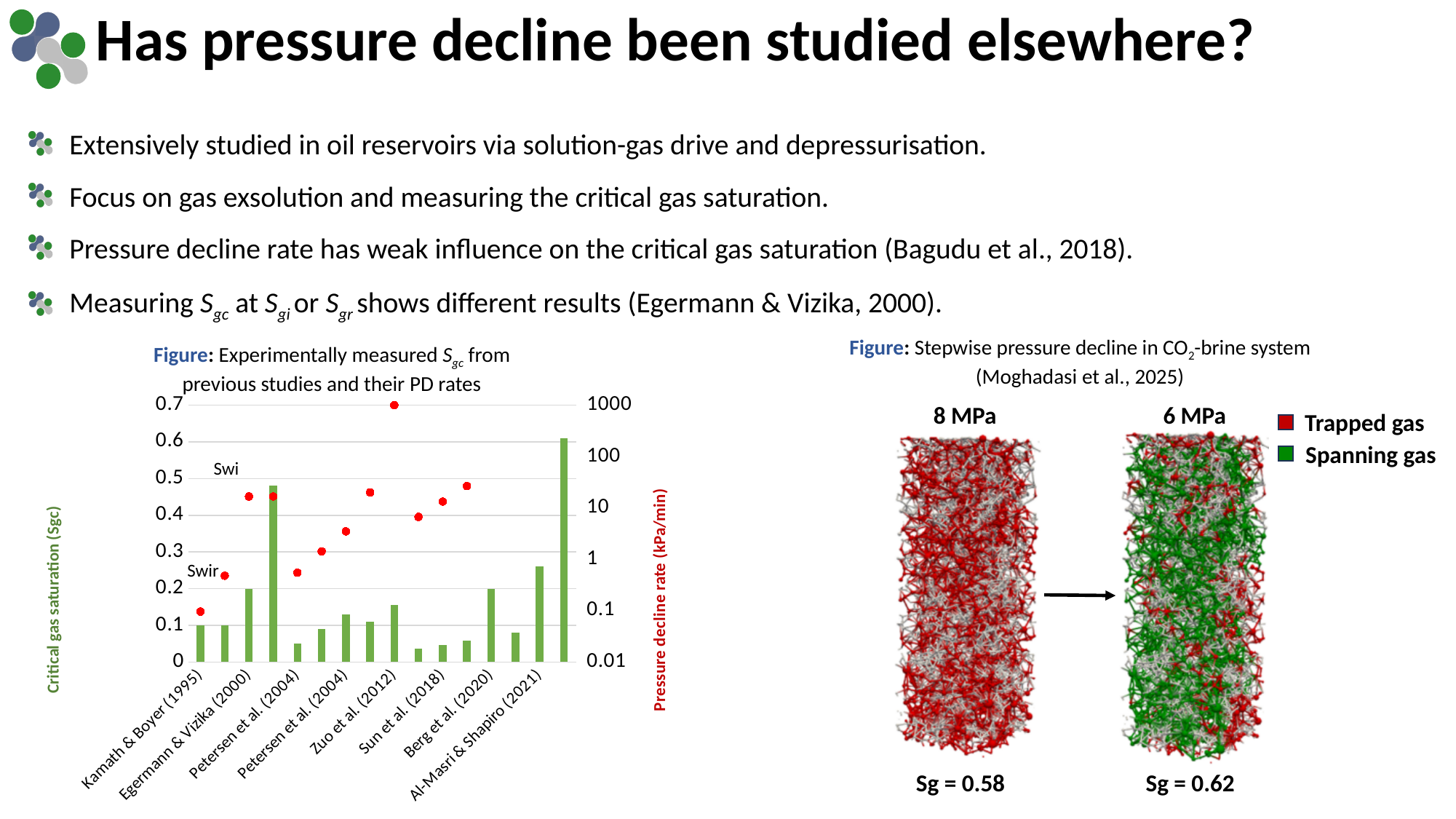
What kind of chart is shown on the left of the slide? bar chart (with scatter points) In the left chart, which has the taller green bar: Zuo et al. (2012) or Sun et al. (2018)? Zuo et al. (2012) In the left chart, is the highest red point greater or less than 100 kPa/min on the right axis? greater What is the highest tick value shown on the left y axis of the left chart? 0.7 In the left chart, is the green bar for Kamath & Boyer (1995) greater or less than 0.2? less In the left chart, what is the title of the left-hand y axis? Critical gas saturation (Sgc) How many study labels are shown along the x axis of the left chart? 8 In the left chart, which has the taller green bar: Kamath & Boyer (1995) or Egermann & Vizika (2000)? Egermann & Vizika (2000) In the left chart, is the tallest green bar greater or less than 0.5 on the left axis? greater In the left chart, what is the title of the right-hand y axis? Pressure decline rate (kPa/min)